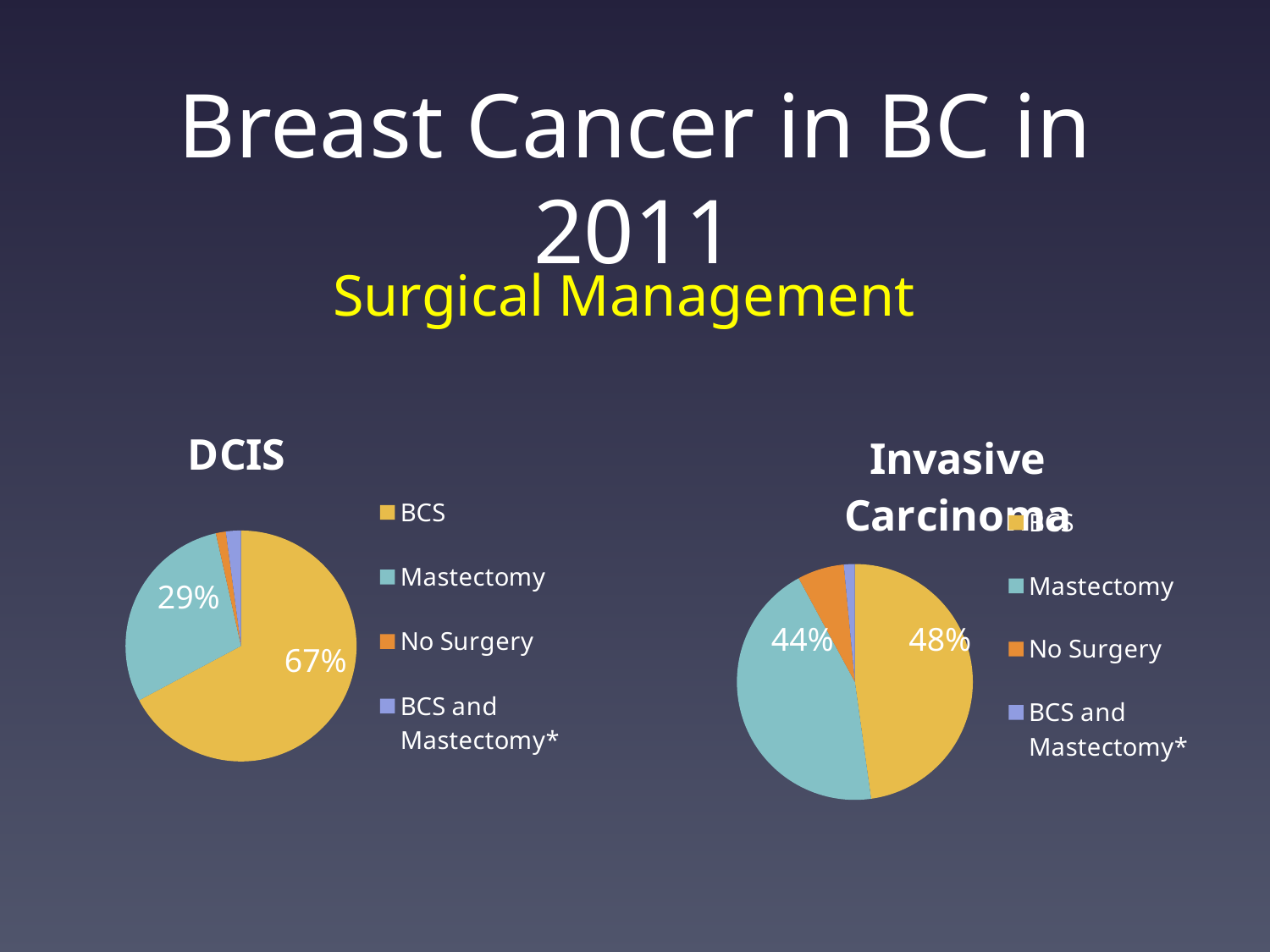
Which is larger in the DCIS pie chart: the BCS slice or the Mastectomy slice? BCS In the Invasive Carcinoma pie chart, what share of cases had BCS? 48% In the Invasive Carcinoma pie chart, which category has the largest slice? BCS In the DCIS pie chart, what share of cases had Mastectomy? 29% What type of chart is used for the Invasive Carcinoma data? Pie chart In the Invasive Carcinoma pie chart, what share of cases had Mastectomy? 44% In the DCIS pie chart, what share of cases had BCS? 67% In the DCIS pie chart, what is the difference between the BCS share and the Mastectomy share? 38% In the Invasive Carcinoma pie chart, what is the difference between the BCS share and the Mastectomy share? 4% In the DCIS pie chart, which category has the largest slice? BCS How many categories does the legend of the DCIS pie chart list? 4 What is the title of the chart on the left side of the slide? DCIS